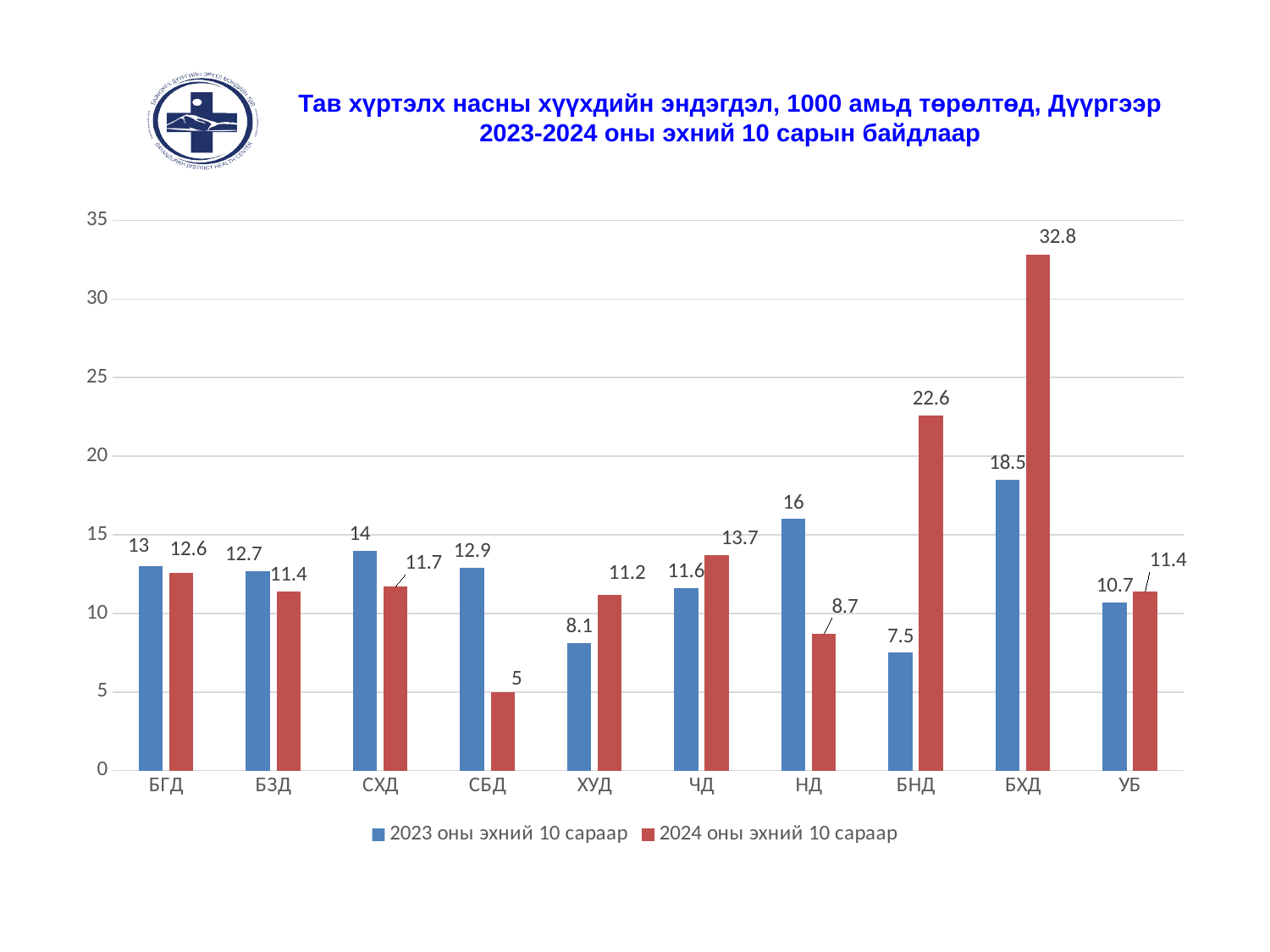
What is the value for БХД in the 2024 оны эхний 10 сараар series? 32.8 Which district has the lowest value in the 2023 оны эхний 10 сараар series? БНД What is the value for НД in the 2023 оны эхний 10 сараар series? 16 What kind of chart is shown on the slide? Bar chart Is the 2024 value for БХД greater or less than 30? greater Which district has the highest value in the 2024 оны эхний 10 сараар series? БХД What colour are the bars for the 2024 оны эхний 10 сараар series? Red How many districts are shown on the x axis? 10 How many series does the legend list? 2 What is the difference between the 2024 and 2023 values for БНД? 15.1 Which is larger for НД: the 2023 value or the 2024 value? 2023 value (16) What is the value for СБД in the 2024 оны эхний 10 сараар series? 5